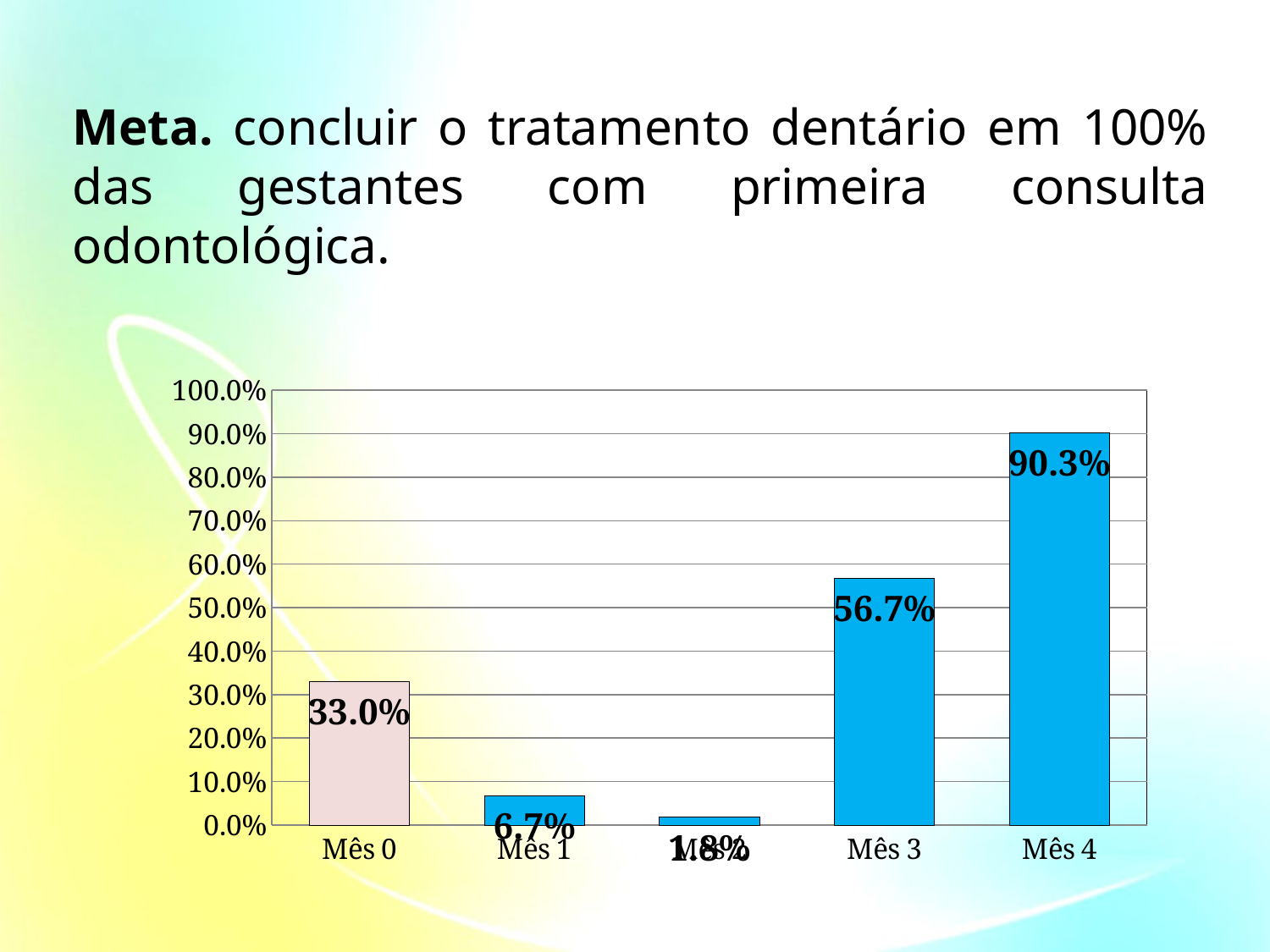
What is the value for Mês 1? 6.7% How many bars are shown in the chart? 5 Is the value for Mês 4 greater or less than 80.0%? greater What is the difference between the values for Mês 0 and Mês 1? 26.3% What kind of chart is shown on the slide? bar chart Which is larger, the value for Mês 0 or the value for Mês 3? Mês 3 What is the value for Mês 4? 90.3% What is the value for Mês 3? 56.7% Which bar is shown in a different colour from the other bars? Mês 0 What is the difference between the values for Mês 4 and Mês 3? 33.6% What is the value for Mês 0? 33.0% Which category has the highest value? Mês 4